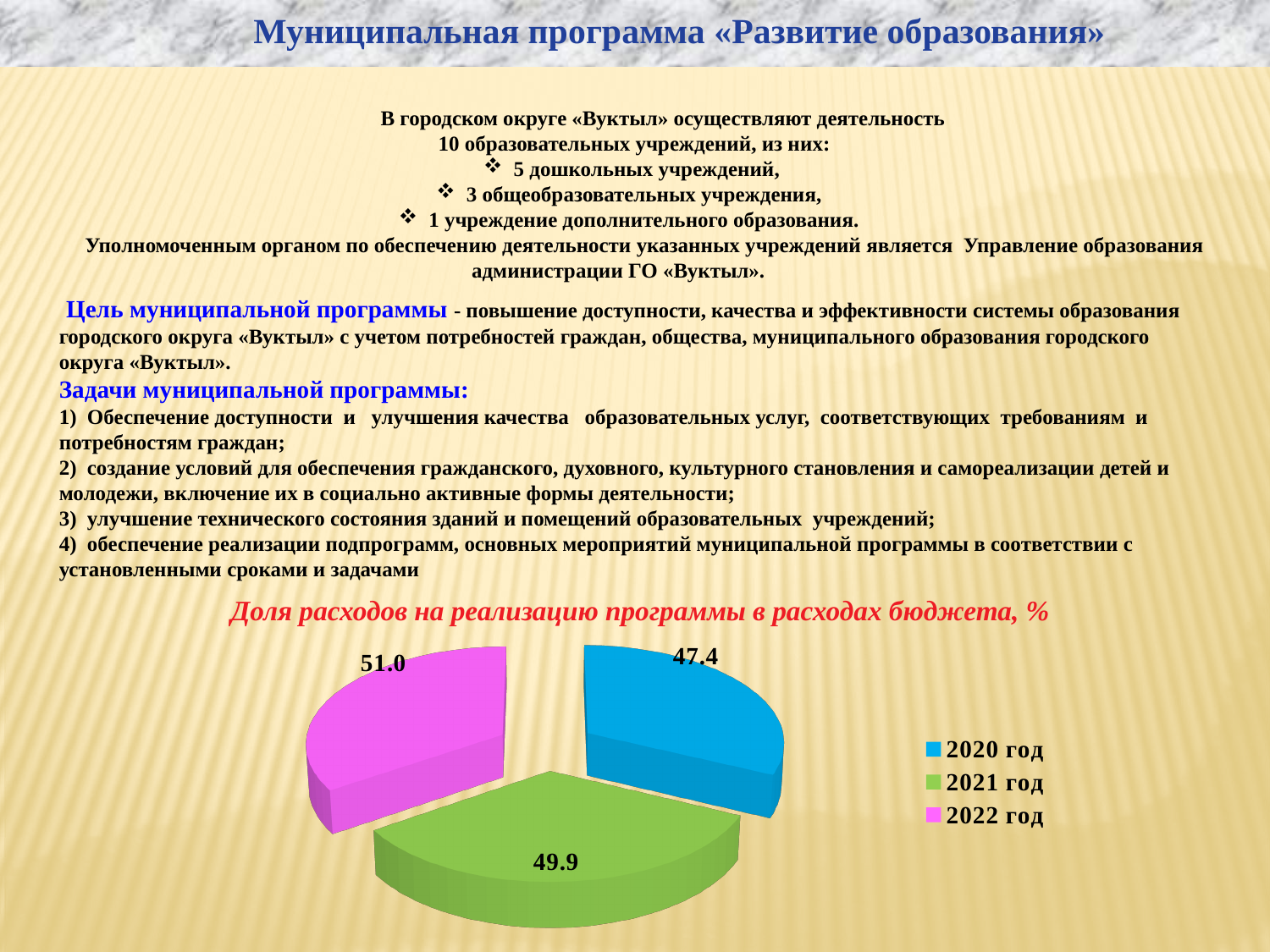
What is the value for 2021 год in the pie chart? 49.9 Which year has the lowest value in the pie chart? 2020 год What is the title of the pie chart? Доля расходов на реализацию программы в расходах бюджета, % What type of chart is shown on the slide? pie chart Which year has the highest value in the pie chart? 2022 год What is the value for 2020 год in the pie chart? 47.4 What is the difference between the values for 2021 год and 2020 год? 2.5 What is the difference between the values for 2022 год and 2020 год? 3.6 What is the value for 2022 год in the pie chart? 51.0 Which colour represents 2021 год in the pie chart? green Which is larger, the value for 2021 год or the value for 2020 год? 2021 год How many slices does the pie chart have? 3